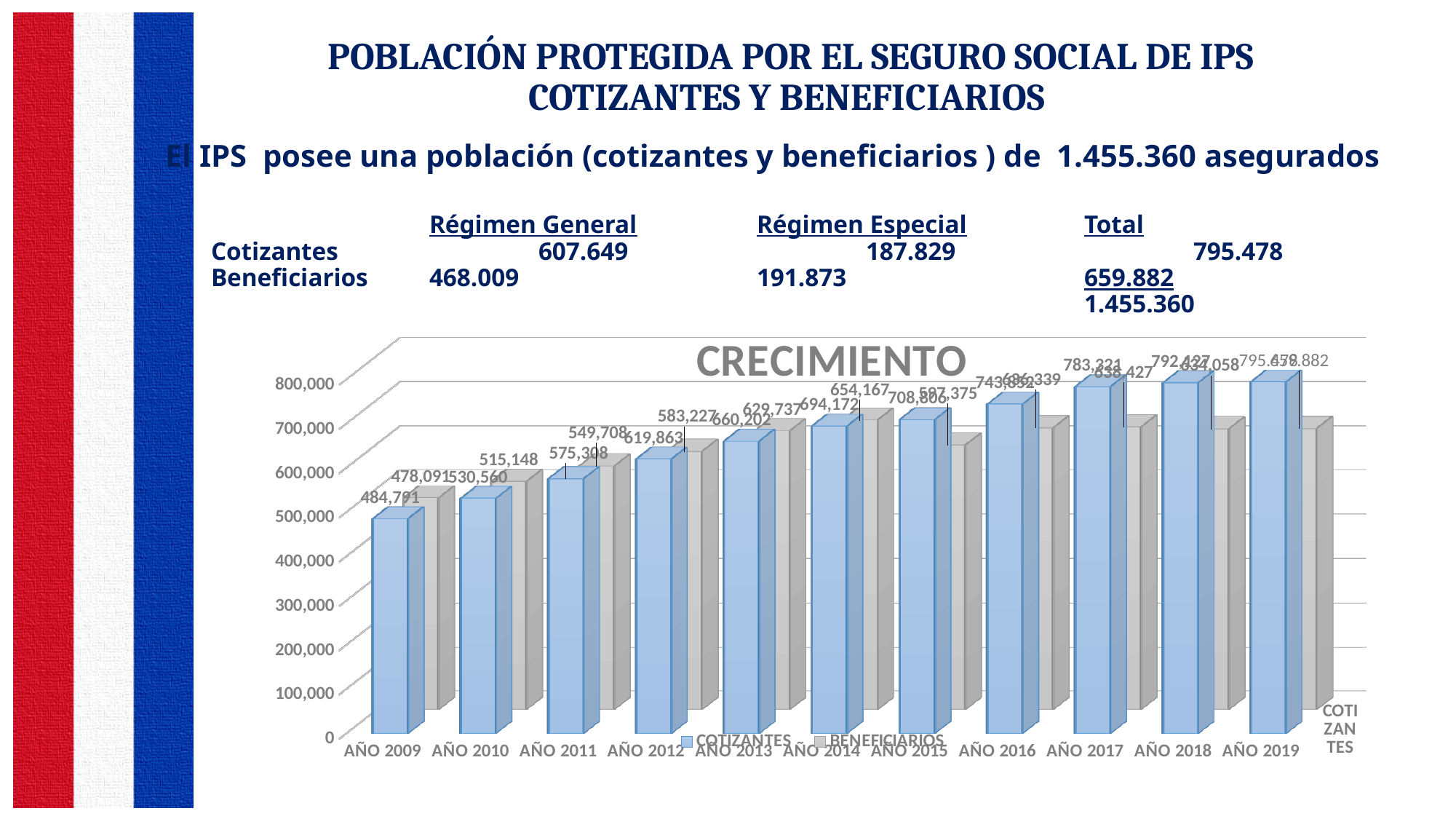
Which colour represents BENEFICIARIOS in the CRECIMIENTO chart? Gray What kind of chart is shown under the title CRECIMIENTO? Bar chart What is the value of COTIZANTES for AÑO 2014 in the CRECIMIENTO chart? 694,172 How many series does the legend of the CRECIMIENTO chart list? 2 In AÑO 2015, which is larger in the CRECIMIENTO chart, COTIZANTES or BENEFICIARIOS? COTIZANTES What is the difference between COTIZANTES and BENEFICIARIOS for AÑO 2019 in the CRECIMIENTO chart? 135,596 Which year has the lowest COTIZANTES value in the CRECIMIENTO chart? AÑO 2009 Do the COTIZANTES values rise or fall from AÑO 2009 to AÑO 2019 in the CRECIMIENTO chart? Rise What is the value of COTIZANTES for AÑO 2010 in the CRECIMIENTO chart? 530,560 What is the value of BENEFICIARIOS for AÑO 2012 in the CRECIMIENTO chart? 583,227 How many years are shown on the x axis of the CRECIMIENTO chart? 11 Which year has the highest COTIZANTES value in the CRECIMIENTO chart? AÑO 2019